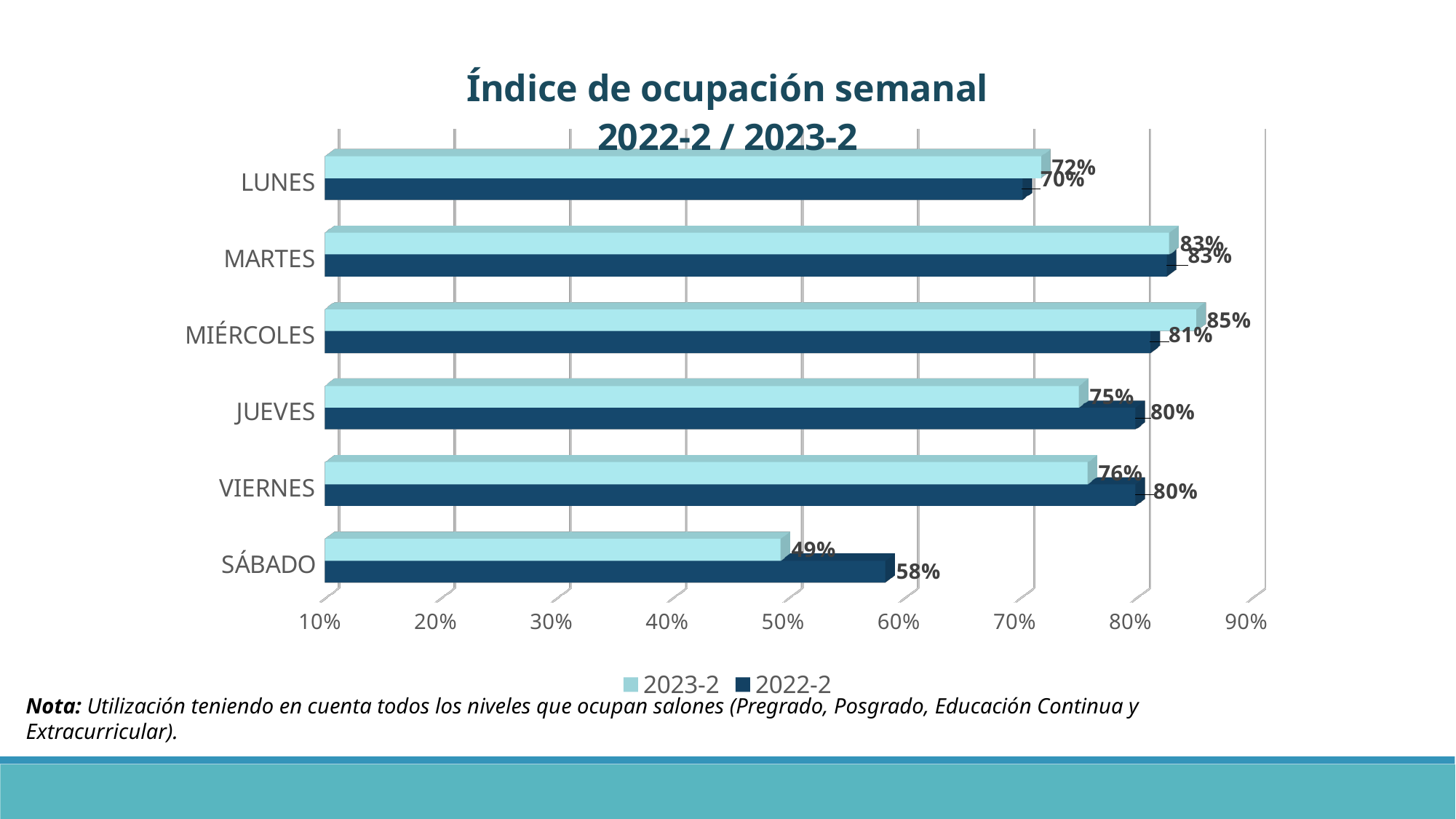
How many days are shown on the chart? 6 Which series is shown in dark blue? 2022-2 What is the value for MIÉRCOLES in the 2023-2 series? 85% What kind of chart is shown on the slide? Bar chart What is the value for JUEVES in the 2023-2 series? 75% What is the difference between the 2022-2 and 2023-2 values for SÁBADO? 9% Which day has the highest value in the 2023-2 series? MIÉRCOLES How many series does the legend list? 2 Which day has the lowest value in the 2022-2 series? SÁBADO What is the title of the chart? Índice de ocupación semanal 2022-2 / 2023-2 Which is larger for VIERNES, the 2023-2 value or the 2022-2 value? 2022-2 What is the value for SÁBADO in the 2022-2 series? 58%